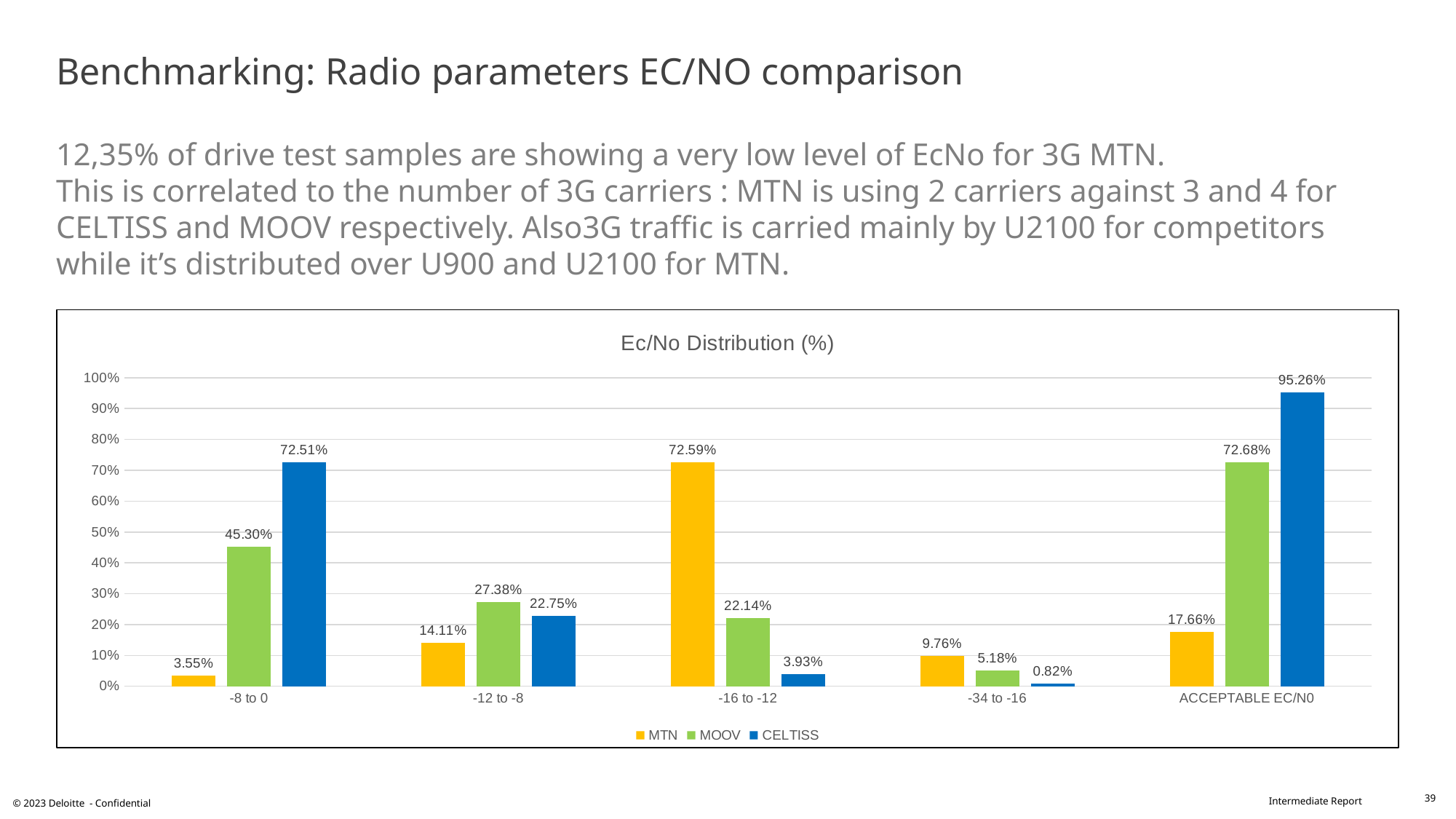
What is the difference between the CELTISS and MTN values in the ACCEPTABLE EC/N0 category? 77.60% What is the value for MTN in the -16 to -12 category? 72.59% What kind of chart is shown on the slide? Bar chart Which series has the highest value in the -12 to -8 category? MOOV What is the value for CELTISS in the ACCEPTABLE EC/N0 category? 95.26% Is the value for MOOV in the -16 to -12 category greater or less than 30%? less Which series has the lowest value in the -34 to -16 category? CELTISS What is the title of the chart? Ec/No Distribution (%) Which is larger in the -8 to 0 category: the MTN value or the CELTISS value? CELTISS How many categories are shown on the x axis? 5 What is the value for MOOV in the -8 to 0 category? 45.30% How many series does the legend list? 3